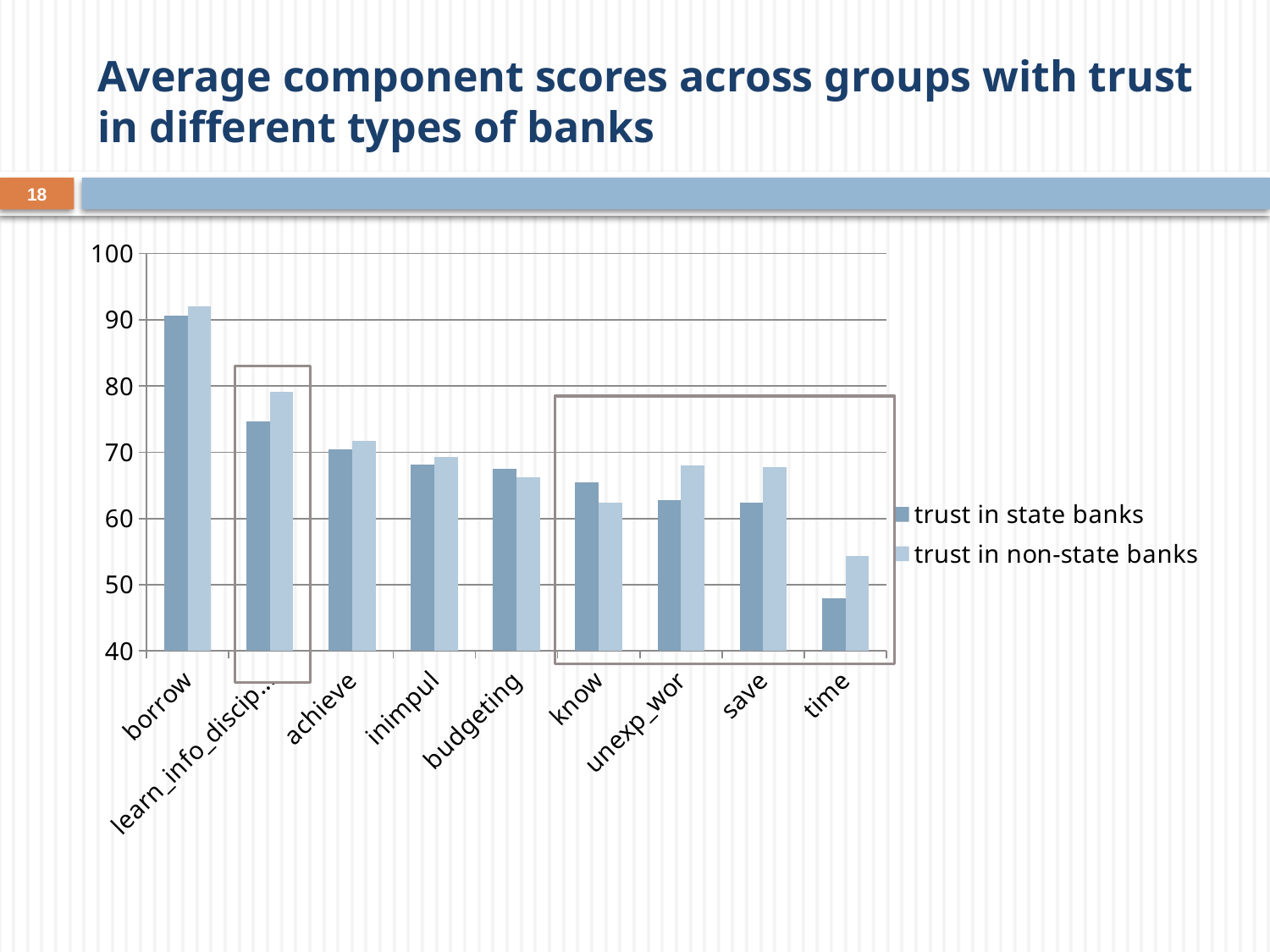
How many series does the legend list? 2 For the category know, which series has the larger value: trust in state banks or trust in non-state banks? trust in state banks Is the value for unexp_wor in the trust in state banks series greater or less than 60? greater Is the value for save in the trust in non-state banks series greater or less than 70? less Is the value for time in the trust in state banks series greater or less than 50? less Which category has the lowest value for trust in non-state banks? time Which category has the highest value for trust in state banks? borrow For the category save, which series has the larger value: trust in state banks or trust in non-state banks? trust in non-state banks How many categories are shown on the x axis? 9 Do the values for trust in state banks rise or fall from left to right along the x axis? fall What kind of chart is shown on the slide? bar chart